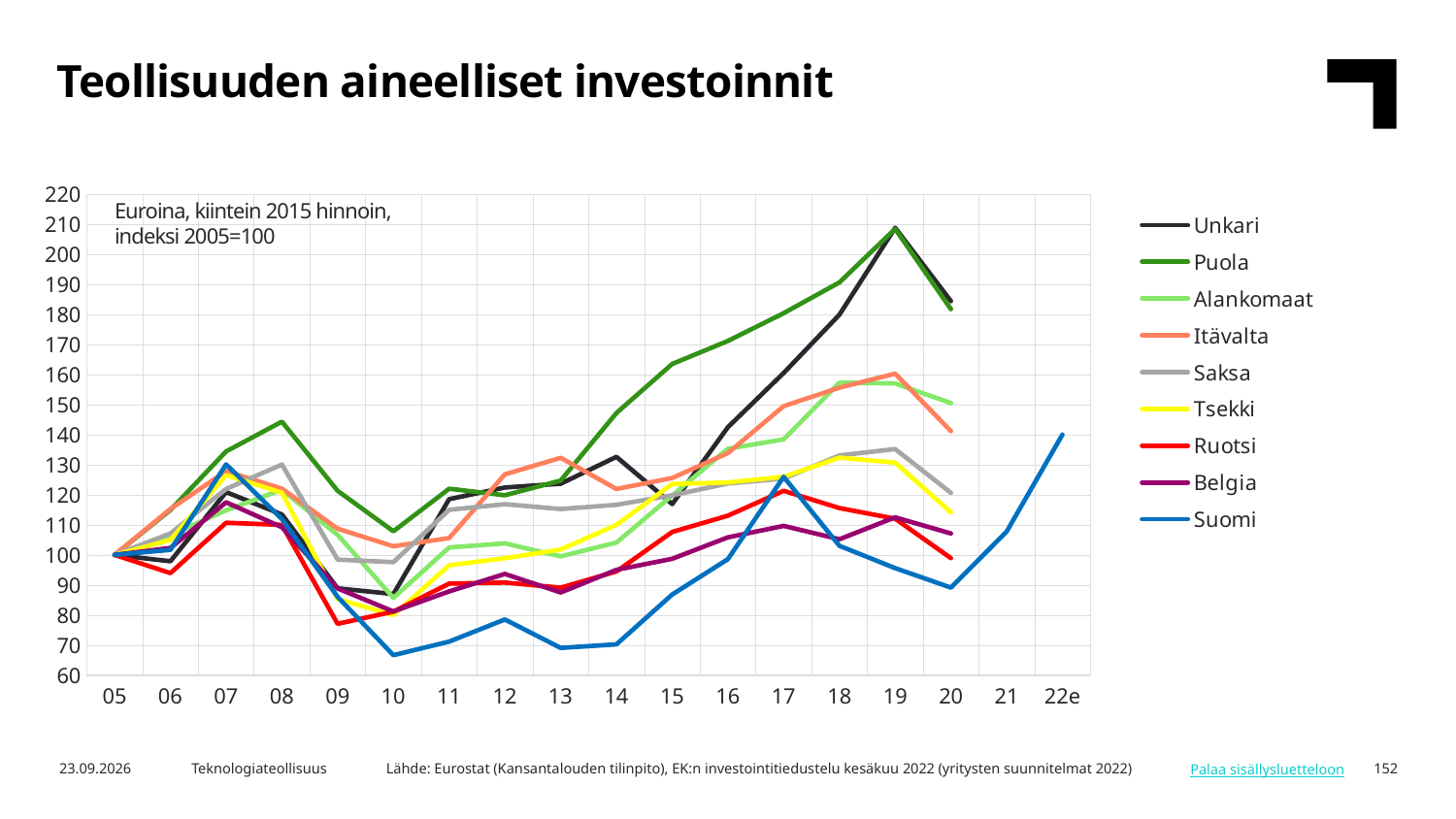
Is the value for Itävalta in 2019 greater or less than 150? greater How many year labels are shown on the x axis? 18 Is the value for Puola in 2019 greater or less than 200? greater Which series has the lowest value in 2010? Suomi Which series has the highest value in 2017? Puola What kind of chart is shown on the slide? line chart Does the value for Suomi rise or fall from 2020 to 22e? rise Is the value for Suomi in 2010 greater or less than 70? less Which series has the lowest value in 2020? Suomi Which series is the only one plotted through to 22e? Suomi How many series does the legend list? 9 Which is larger in 2013, the value for Suomi or the value for Ruotsi? Ruotsi